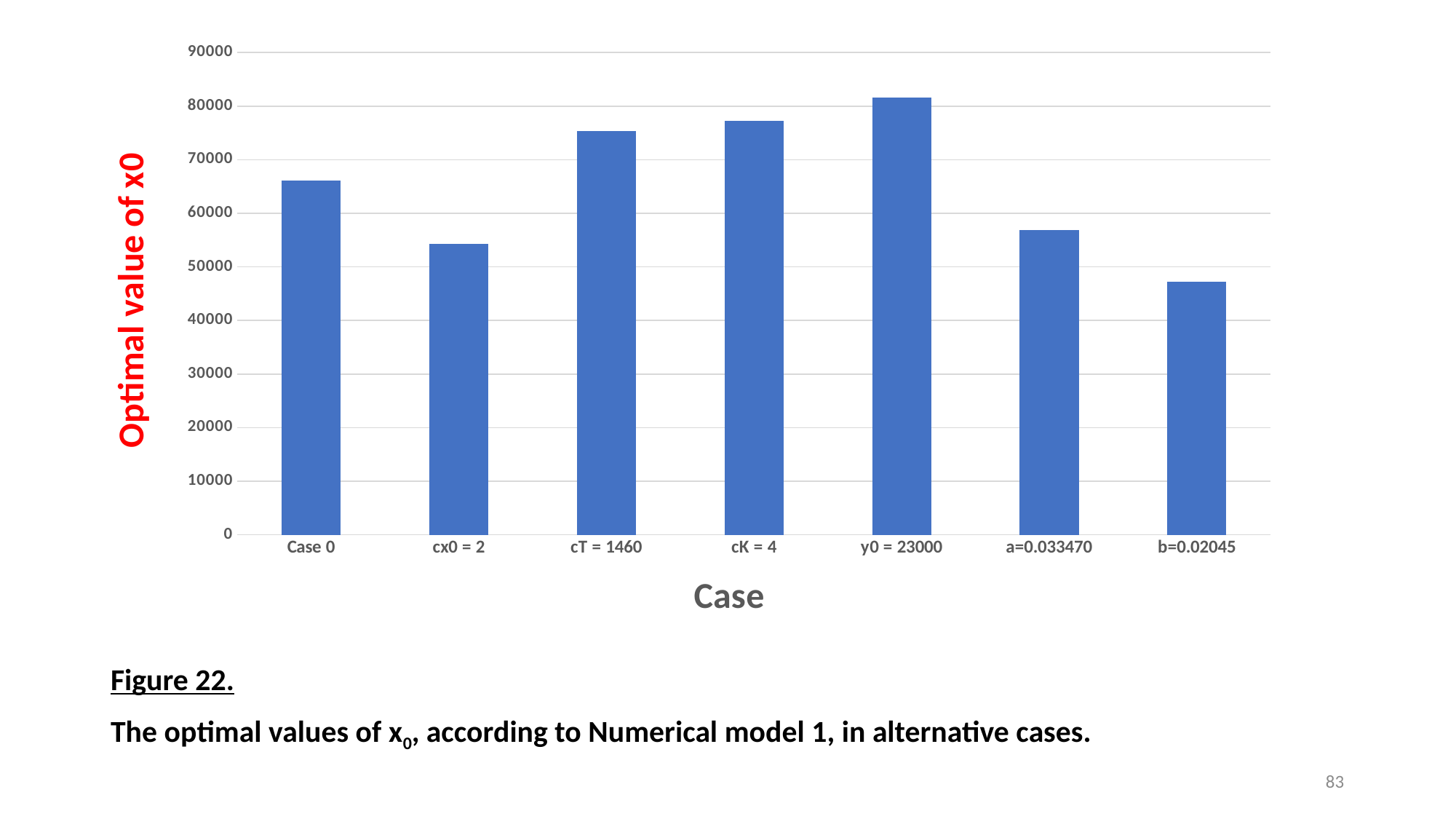
Which case has the highest optimal value of x0? y0 = 23000 Is the value for Case 0 greater or less than 60000? greater Is the value for cx0 = 2 greater or less than 60000? less Is the value for cT = 1460 greater or less than 70000? greater Which is larger, the value for cK = 4 or the value for a=0.033470? cK = 4 Which case has the lowest optimal value of x0? b=0.02045 Which is larger, the value for Case 0 or the value for cx0 = 2? Case 0 What is the title of the vertical axis of the chart? Optimal value of x0 What kind of chart is shown on the slide? bar chart How many cases are plotted on the x axis of the chart? 7